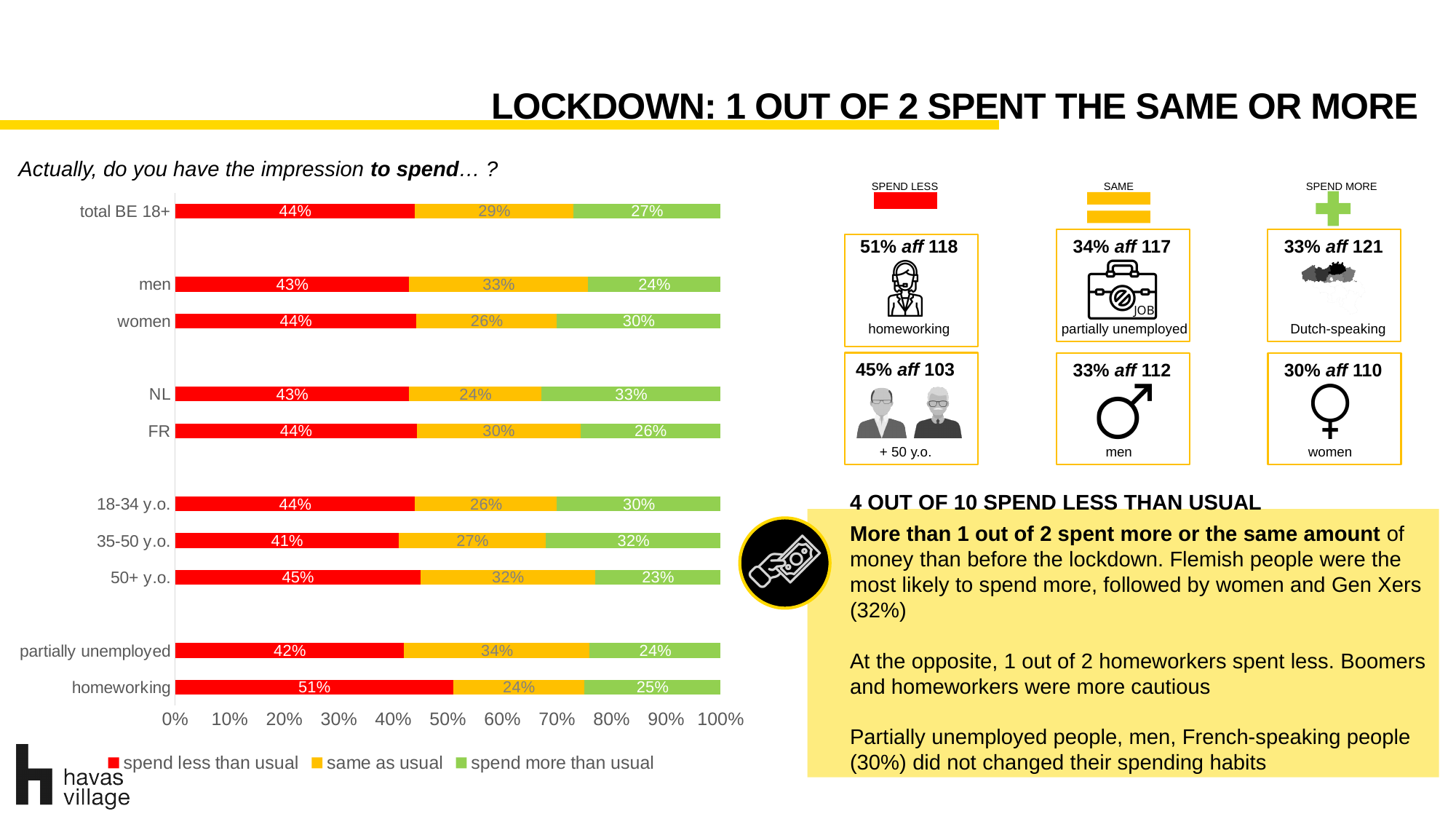
What percentage of homeworking respondents spend less than usual? 51% What is the 'same as usual' value for partially unemployed respondents? 34% What kind of chart is shown on the slide? stacked bar chart Which category has the highest 'spend less than usual' value? homeworking What percentage of NL respondents spend more than usual? 33% Which category has the lowest 'spend more than usual' value? 50+ y.o. Which colour represents 'same as usual' in the chart? yellow/orange Which is larger: the 'spend more than usual' value for women or for men? women What is the total of the stacked bar for total BE 18+? 100% How many categories are shown on the chart? 10 What is the difference between the 'spend less than usual' values for homeworking and 35-50 y.o.? 10% How many series does the legend list? 3